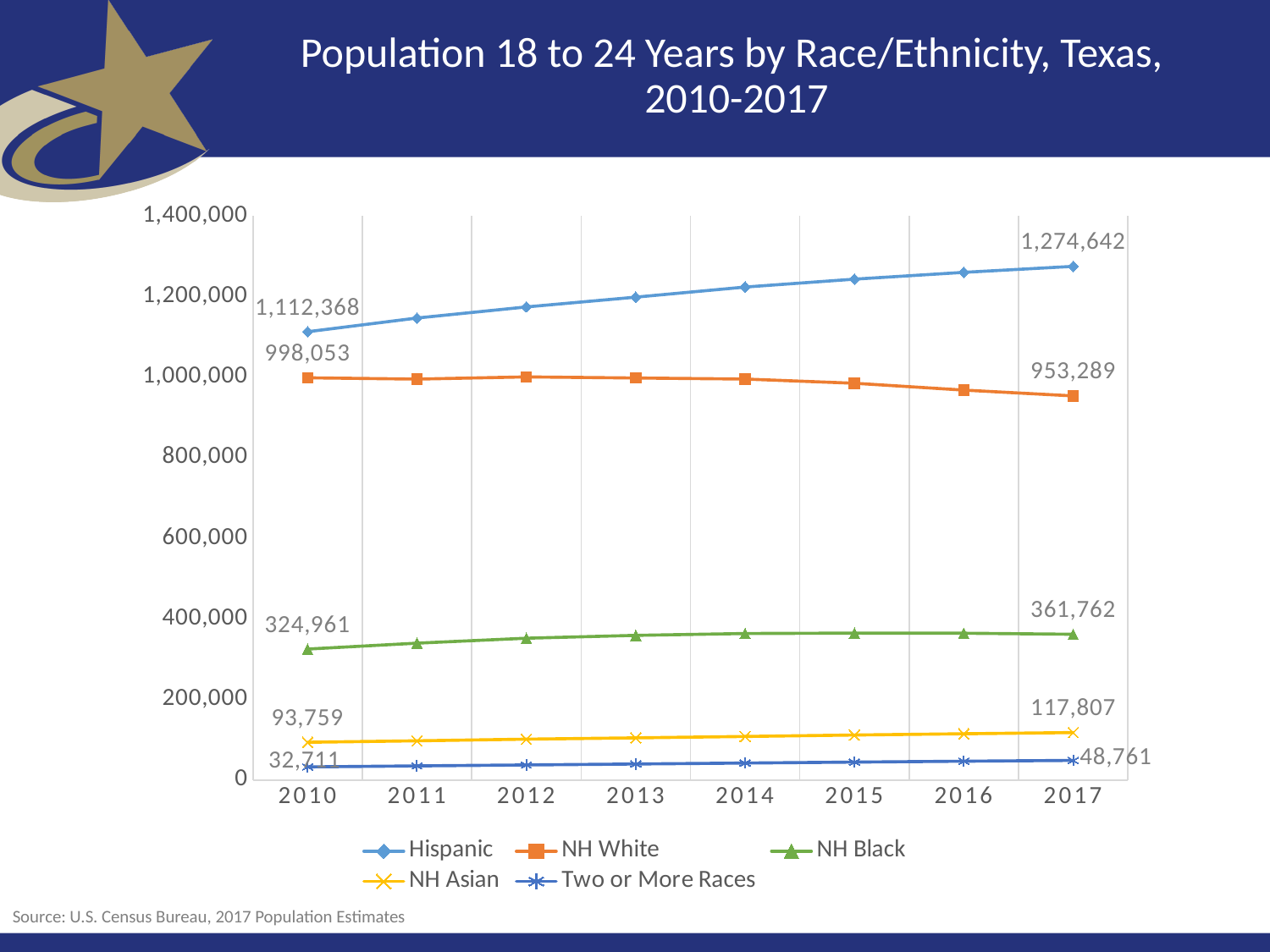
How many series does the legend list? 5 What was the NH White population aged 18 to 24 in Texas in 2010? 998,053 Is the NH Black value for 2014 greater or less than 400,000? less Which was larger in 2017, the NH Asian population or the Two or More Races population? NH Asian By how much did the NH White population decrease from 2010 to 2017? 44,764 What value is shown for NH Black in 2017? 361,762 Which race/ethnicity group had the highest population in 2017? Hispanic What value is shown for Two or More Races in 2010? 32,711 By how much did the Hispanic population change from 2010 to 2017? 162,274 What was the Hispanic population aged 18 to 24 in Texas in 2017? 1,274,642 Does the NH White line rise or fall from 2010 to 2017? fall Which race/ethnicity group had the lowest population in 2010? Two or More Races